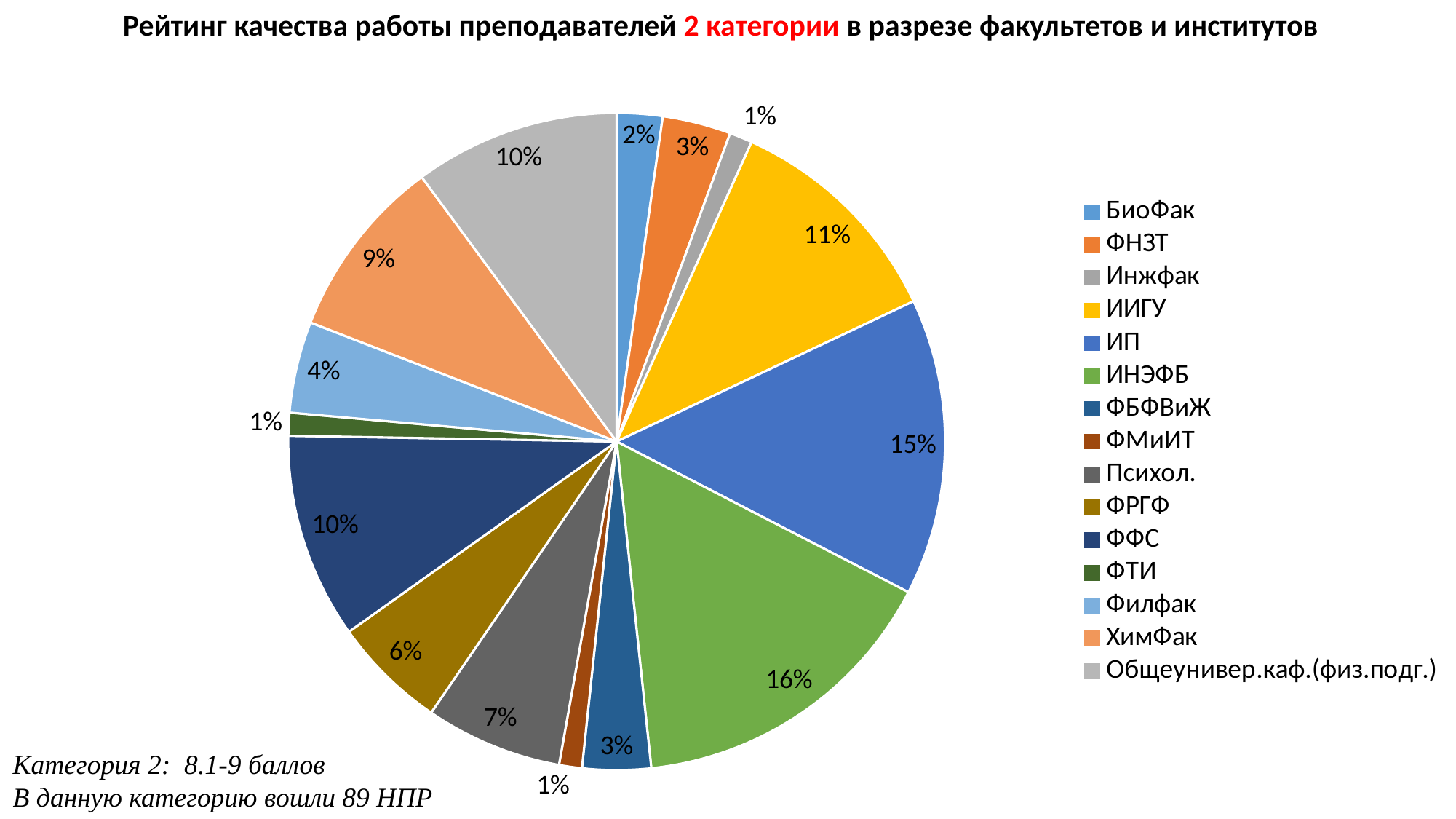
According to the note on the slide, how many НПР are included in category 2? 89 How many categories does the legend list? 15 What is the value shown for ФБФВиЖ? 3% Which is larger, the slice for ФРГФ or the slice for Филфак? ФРГФ What percentage is shown for Психол.? 7% What share of the pie does ИНЭФБ hold? 16% Which category has the largest slice of the pie? ИНЭФБ What is the difference between the values for ИНЭФБ and ФФС? 6% What is the value for ХимФак? 9% What is the value shown for ИП? 15% What kind of chart is shown on the slide? pie chart What percentage is shown for ИИГУ? 11%